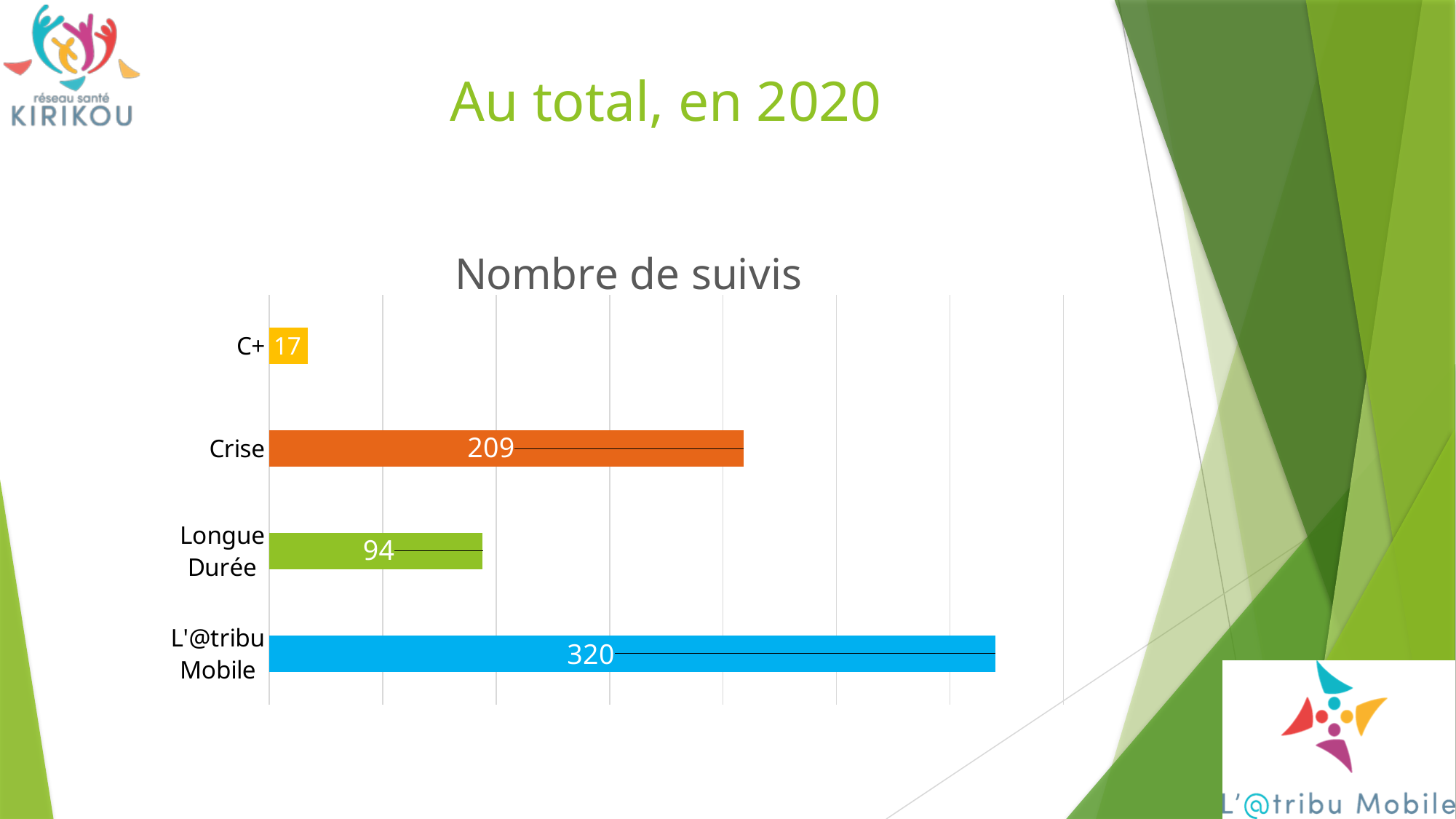
What kind of chart is shown on the slide? Bar chart Which is larger, the value for Crise or the value for Longue Durée? Crise How many categories are shown in the Nombre de suivis chart? 4 What is the difference between the values for Crise and Longue Durée? 115 What is the title of the chart on the slide? Nombre de suivis What is the value for L'@tribu Mobile in the Nombre de suivis chart? 320 What is the value for Longue Durée in the Nombre de suivis chart? 94 Which category has the highest value in the Nombre de suivis chart? L'@tribu Mobile Which category has the lowest value in the Nombre de suivis chart? C+ What is the value for C+ in the Nombre de suivis chart? 17 What is the value for Crise in the Nombre de suivis chart? 209 What is the difference between the values for L'@tribu Mobile and Crise? 111